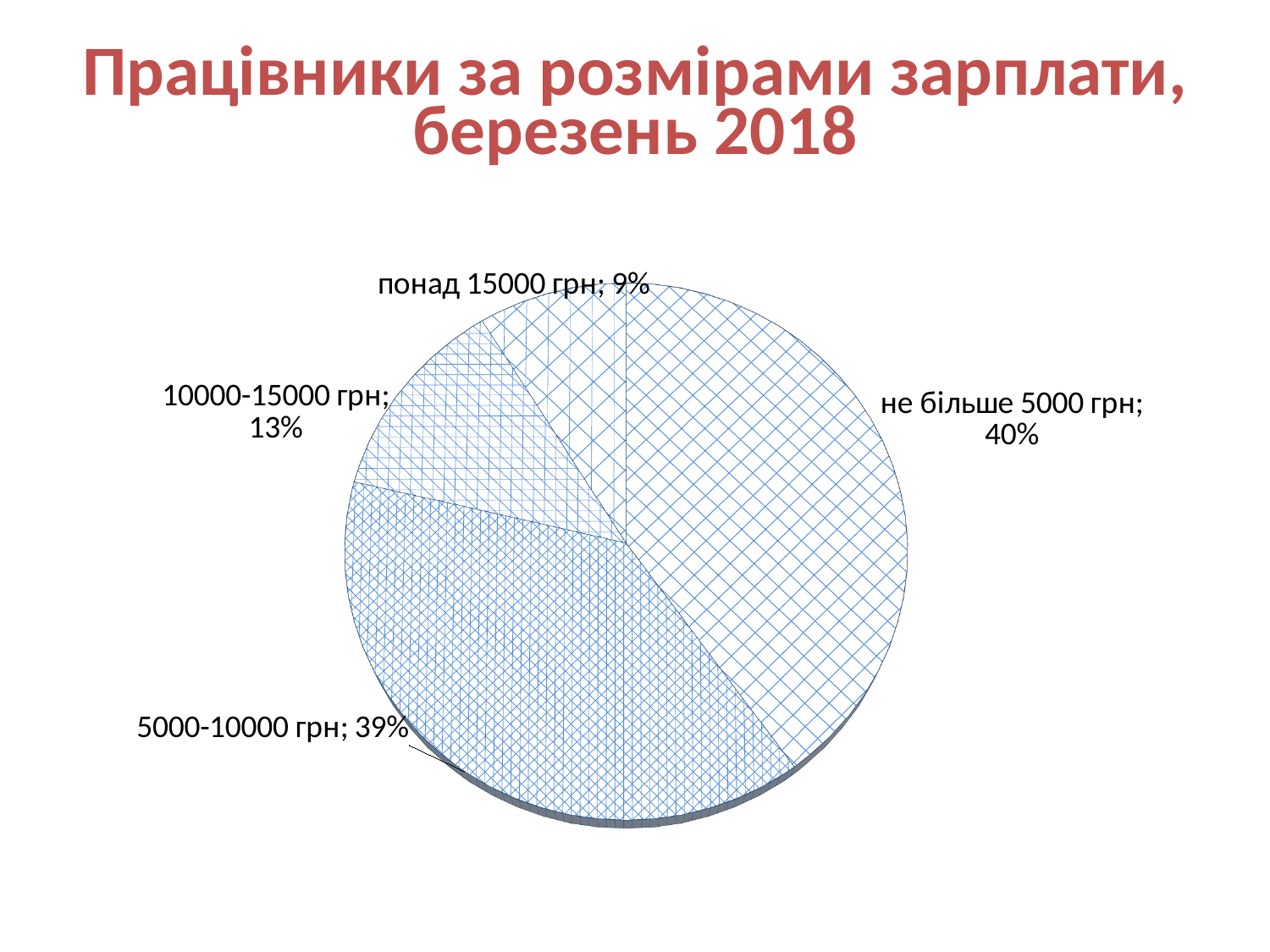
What is the difference in percentage points between the 10000-15000 грн slice and the понад 15000 грн slice? 4 What is the title of the chart? Працівники за розмірами зарплати, березень 2018 How many slices does the pie chart have? 4 What is the combined share of the 10000-15000 грн and понад 15000 грн slices? 22% What share of workers earn 5000-10000 грн? 39% What type of chart is shown on the slide? pie chart Which salary category has the smallest share? понад 15000 грн Which is larger: the share for 10000-15000 грн or the share for понад 15000 грн? 10000-15000 грн Which salary category has the largest share? не більше 5000 грн What share of workers earn не більше 5000 грн? 40% What share of workers earn понад 15000 грн? 9% What share of workers earn 10000-15000 грн? 13%